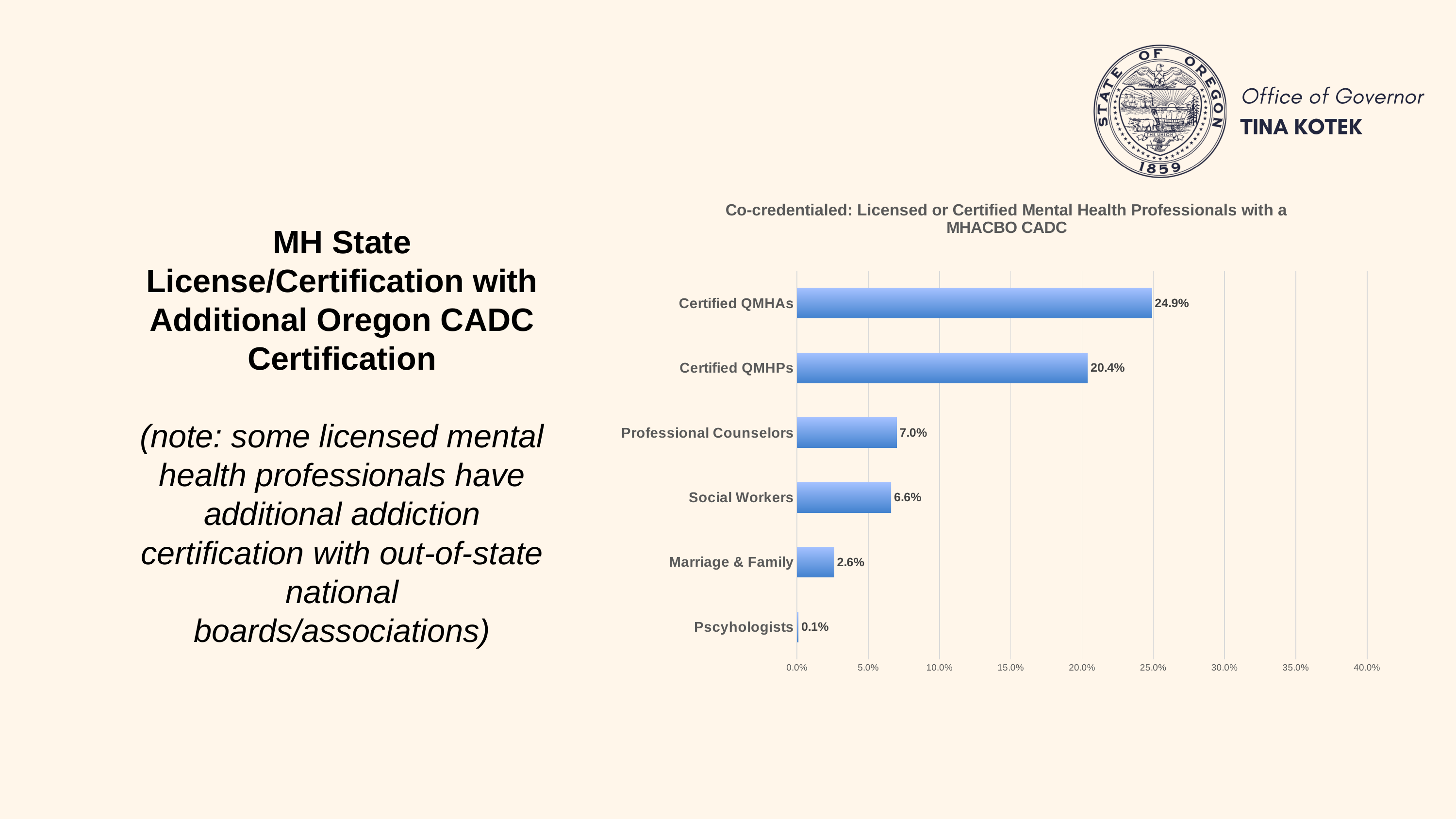
What is the highest value shown on the x axis? 40.0% What is the value for Professional Counselors? 7.0% What is the title of the chart? Co-credentialed: Licensed or Certified Mental Health Professionals with a MHACBO CADC Which is larger, the value for Professional Counselors or the value for Social Workers? Professional Counselors Is the value for Certified QMHPs greater or less than 15.0%? greater Which category has the highest value? Certified QMHAs Which category has the lowest value? Pscyhologists How many categories are shown in the chart? 6 What is the difference between the values for Certified QMHAs and Certified QMHPs? 4.5% What is the value for Marriage & Family? 2.6% What kind of chart is shown on the slide? bar chart What is the value for Certified QMHAs? 24.9%